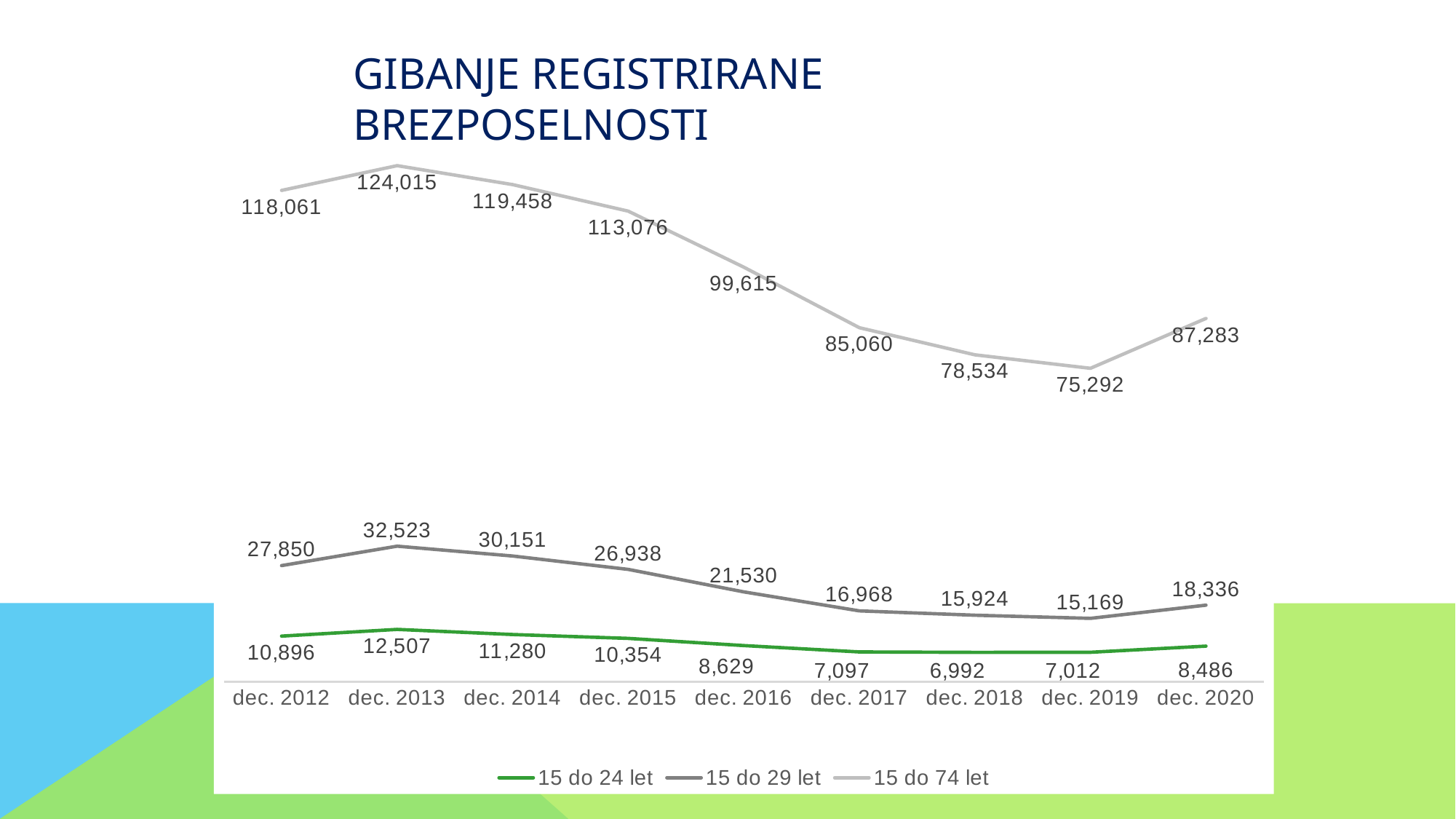
In which period is the 15 do 74 let series at its lowest? dec. 2019 How many time points are plotted on the x axis? 9 What kind of chart is shown on the slide? line chart What is the value for the 15 do 29 let series in dec. 2020? 18,336 In which period is the 15 do 29 let series at its highest? dec. 2013 Does the 15 do 74 let series rise or fall from dec. 2013 to dec. 2019? fall What is the value for the 15 do 24 let series in dec. 2018? 6,992 Which is larger for the 15 do 24 let series: dec. 2012 or dec. 2020? dec. 2012 What colour is the line for the 15 do 24 let series? green How many series does the legend list? 3 What is the value for the 15 do 74 let series in dec. 2013? 124,015 What is the difference between the 15 do 74 let values in dec. 2013 and dec. 2019? 48,723